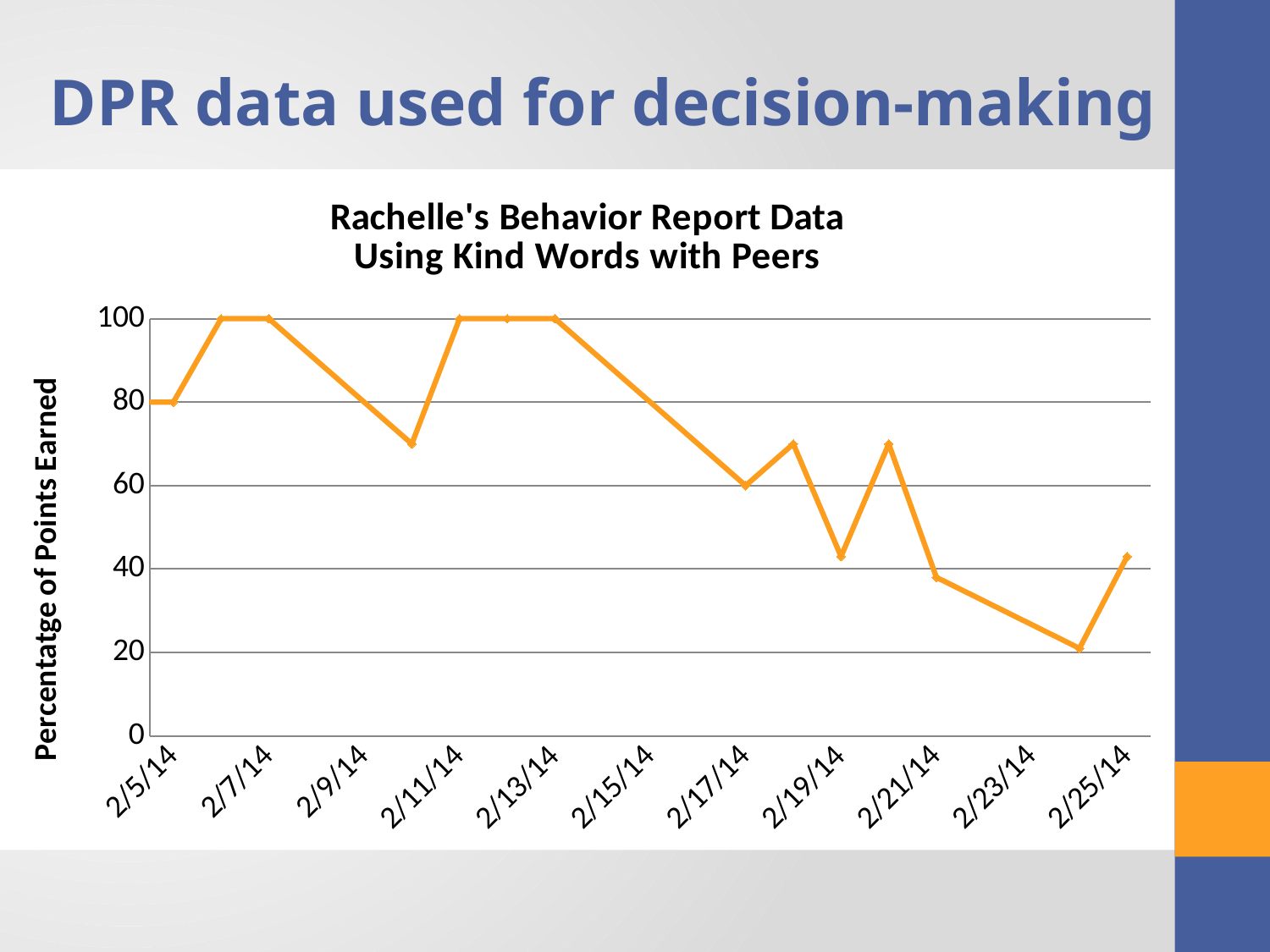
What is the percentage of points earned on 2/7/14? 100 What is the percentage of points earned on 2/13/14? 100 What is the percentage of points earned on 2/5/14? 80 What is the title of the chart? Rachelle's Behavior Report Data Using Kind Words with Peers Overall, do the values rise or fall from 2/5/14 to 2/25/14? fall Is the value for 2/21/14 greater or less than 40? less Is the value for 2/25/14 greater or less than 40? greater What is the highest percentage of points earned shown on the chart? 100 Which date has the larger value, 2/7/14 or 2/25/14? 2/7/14 What kind of chart is shown on the slide? line chart